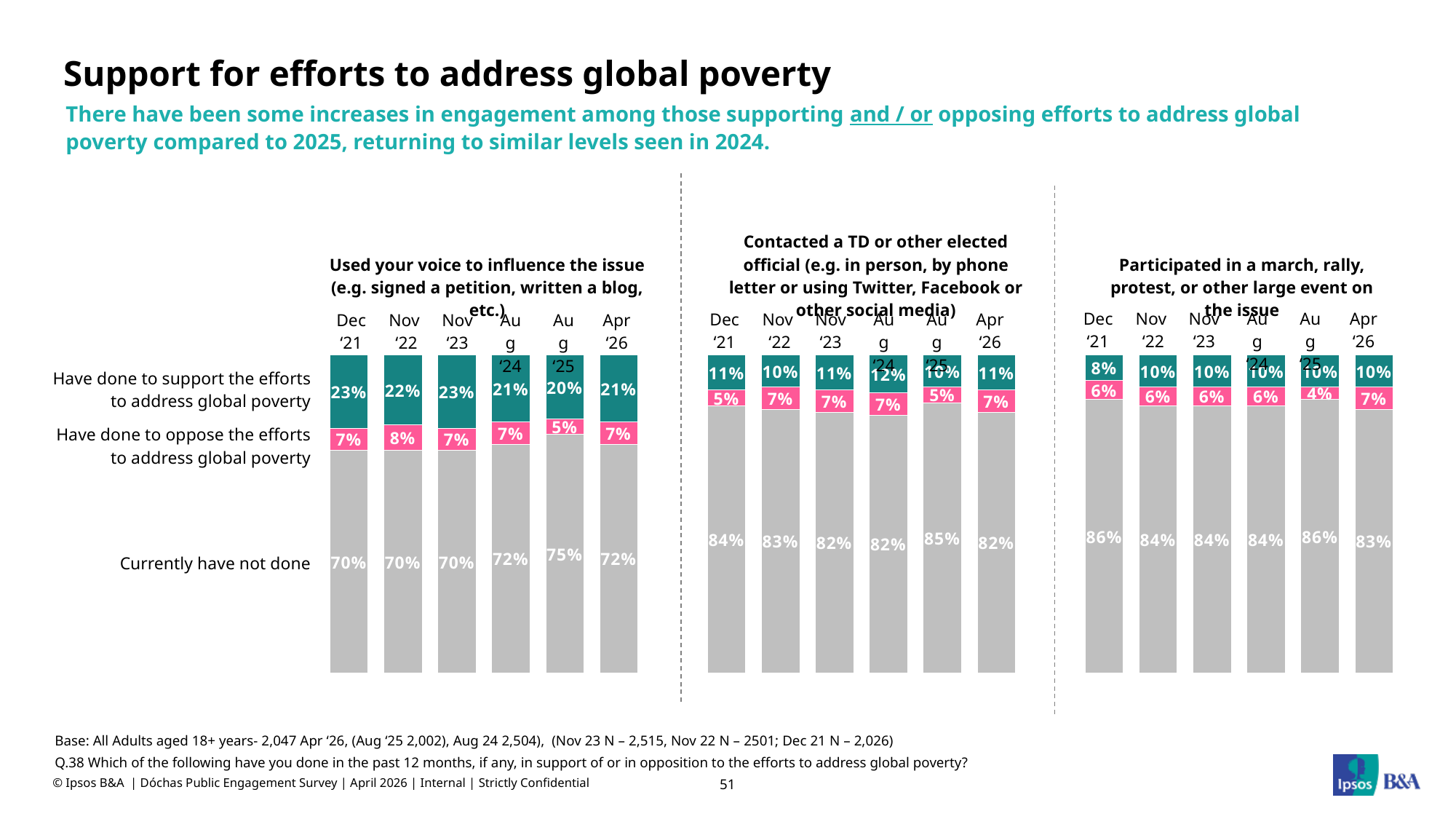
In the 'Used your voice to influence the issue' chart, what percentage currently had not done anything in Aug '25? 75% In the 'Used your voice to influence the issue' chart, what is the difference between the 'Have done to support' values for Dec '21 and Aug '25? 3 percentage points In the 'Participated in a march, rally, protest, or other large event' chart, what percentage had done something to oppose the efforts in Apr '26? 7% In the 'Contacted a TD or other elected official' chart, which wave has the highest 'Currently have not done' value? Aug '25 What type of chart is used on this slide? Stacked bar chart How many time periods are shown on the x axis of each chart? 6 In the 'Contacted a TD or other elected official' chart, what percentage had done something to support the efforts in Aug '24? 12% In the 'Contacted a TD or other elected official' chart, is the 'Have done to oppose' value larger in Nov '22 or Aug '25? Nov '22 In the 'Used your voice to influence the issue' chart, what percentage had done something to oppose the efforts in Aug '25? 5% In the 'Participated in a march, rally, protest, or other large event' chart, which wave has the lowest 'Have done to support the efforts' value? Dec '21 In the 'Used your voice to influence the issue' chart, what percentage had done something to support the efforts in Dec '21? 23% How many response categories are stacked in each bar? 3